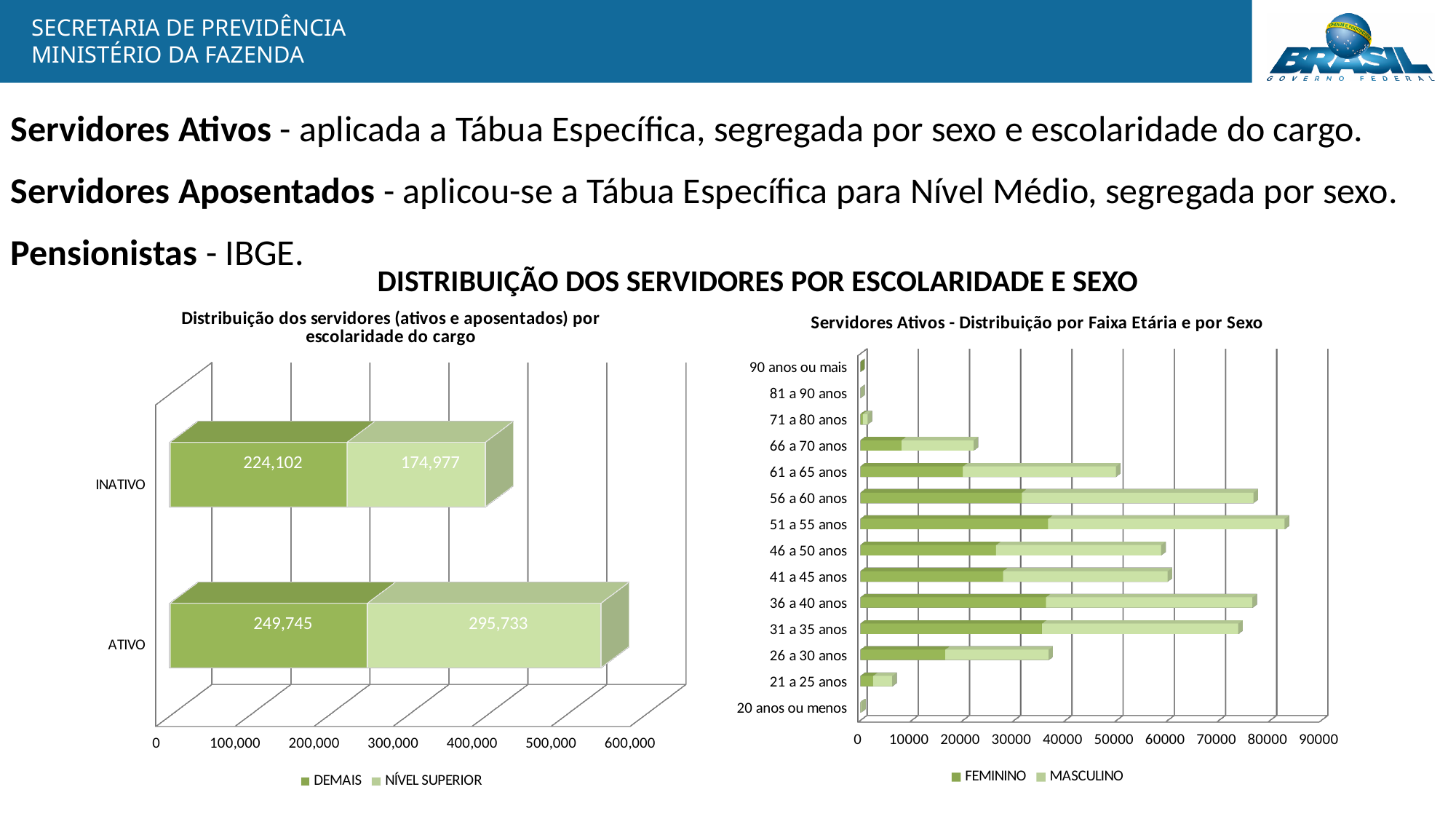
In the right chart (Servidores Ativos - Distribuição por Faixa Etária e por Sexo), what are the two series listed in the legend? FEMININO and MASCULINO In the left chart (Distribuição dos servidores por escolaridade do cargo), what is the value for DEMAIS in the ATIVO category? 249,745 What kind of chart is the right chart (Servidores Ativos - Distribuição por Faixa Etária e por Sexo)? Stacked bar chart In the right chart (Servidores Ativos - Distribuição por Faixa Etária e por Sexo), is the total for 26 a 30 anos greater or less than 40000? less In the left chart (Distribuição dos servidores por escolaridade do cargo), what is the value for NÍVEL SUPERIOR in the INATIVO category? 174,977 In the right chart (Servidores Ativos - Distribuição por Faixa Etária e por Sexo), which age group has the highest total? 51 a 55 anos In the left chart (Distribuição dos servidores por escolaridade do cargo), which is larger for INATIVO: DEMAIS or NÍVEL SUPERIOR? DEMAIS In the left chart (Distribuição dos servidores por escolaridade do cargo), what is the total of the stacked bar for INATIVO? 399,079 In the left chart (Distribuição dos servidores por escolaridade do cargo), how many series does the legend list? 2 In the left chart (Distribuição dos servidores por escolaridade do cargo), what is the total of the stacked bar for ATIVO? 545,478 In the left chart (Distribuição dos servidores por escolaridade do cargo), what is the difference between NÍVEL SUPERIOR and DEMAIS for ATIVO? 45,988 In the right chart (Servidores Ativos - Distribuição por Faixa Etária e por Sexo), how many age-group categories are shown? 14